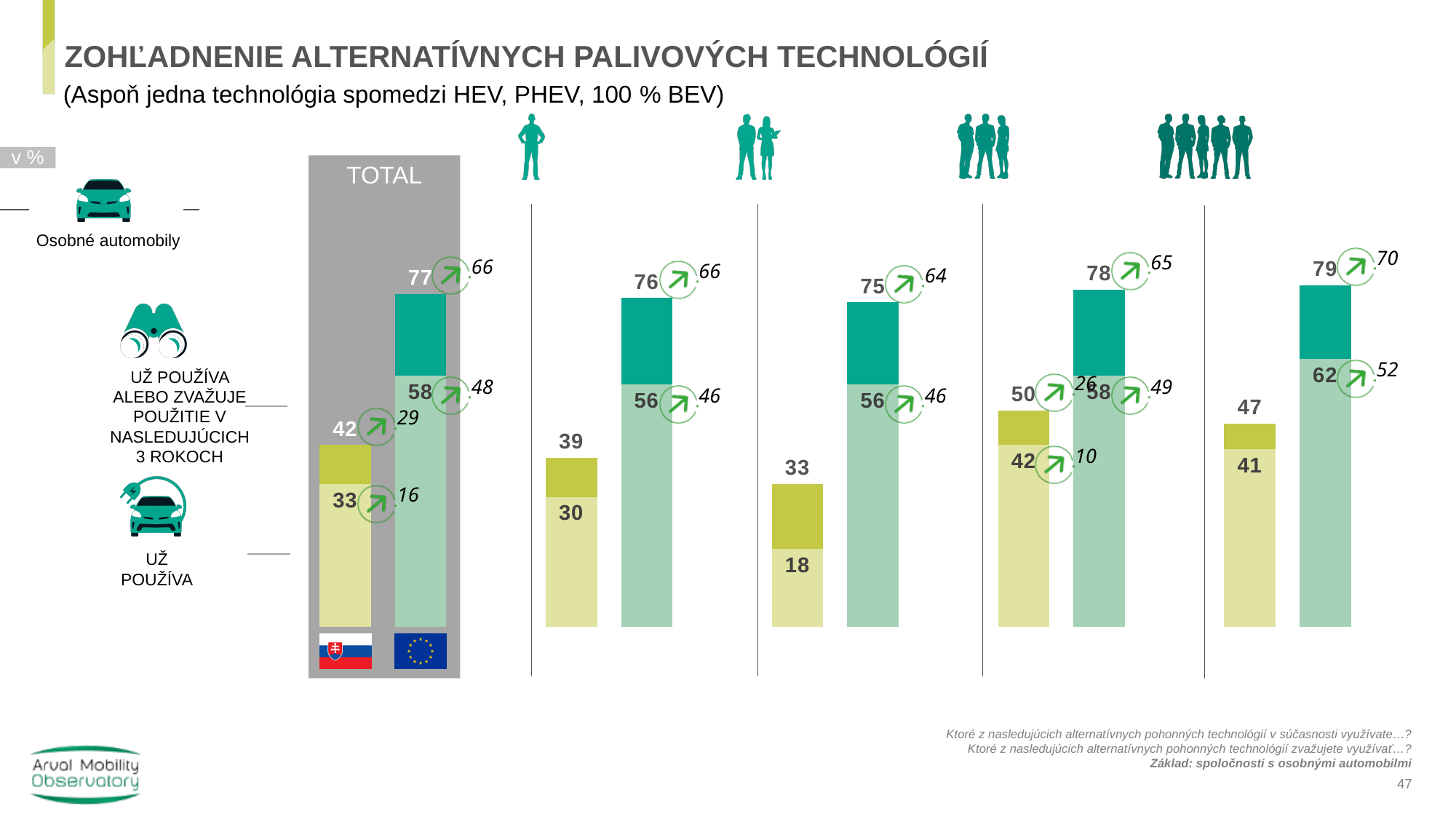
In the third group to the right of TOTAL (three-person icon), which is larger: the Slovak or the EU value for 'už používa alebo zvažuje použitie'? EU (78 vs 50) In the TOTAL column, what is the EU value for 'už používa'? 58 Which group has the lowest Slovak value for 'už používa'? The second group to the right of TOTAL (two-person icon), 18 In what unit are the values on the chart expressed, according to the label at the top left? v % In the TOTAL column, what is the Slovak value for 'už používa alebo zvažuje použitie v nasledujúcich 3 rokoch'? 42 What kind of chart is shown on the slide? Stacked bar chart In the rightmost group (largest company icon), what is the EU value for 'už používa alebo zvažuje použitie'? 79 In the first group to the right of TOTAL (single-person icon), what is the Slovak value for 'už používa'? 30 Which group has the highest EU value for 'už používa alebo zvažuje použitie'? The rightmost group (largest company icon), 79 In the TOTAL column, what is the difference between the EU and Slovak values for 'už používa alebo zvažuje použitie'? 35 How many groups of bars (including TOTAL) are shown on the chart? 5 What italic number appears next to the arrow beside the EU TOTAL value of 77? 66